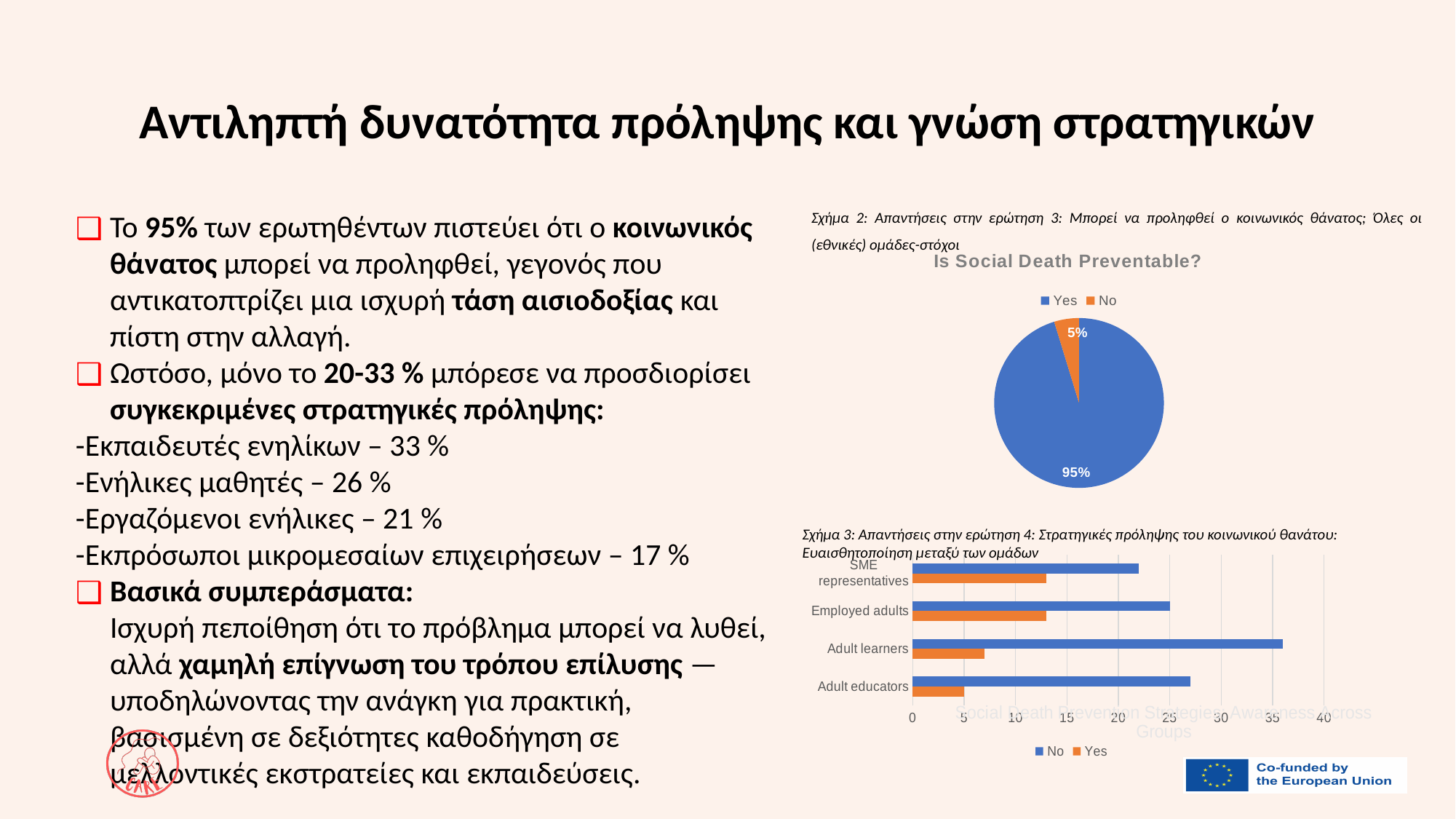
On the pie chart 'Is Social Death Preventable?', by how many percentage points does Yes exceed No? 90 percentage points On the bar chart 'Social Death Prevention Strategies: Awareness Across Groups', is the 'Yes' value for Adult educators greater or less than 10? less On the bar chart 'Social Death Prevention Strategies: Awareness Across Groups', which is larger: the 'No' value for Adult learners or the 'No' value for Adult educators? Adult learners On the bar chart 'Social Death Prevention Strategies: Awareness Across Groups', is the 'No' value for Adult learners greater or less than 30? greater What kind of chart is the upper chart on the right, 'Is Social Death Preventable?'? Pie chart On the bar chart 'Social Death Prevention Strategies: Awareness Across Groups', how many series does the legend list? 2 On the pie chart 'Is Social Death Preventable?', what percentage answered Yes? 95% On the bar chart 'Social Death Prevention Strategies: Awareness Across Groups', which group has the highest 'No' value? Adult learners On the pie chart 'Is Social Death Preventable?', which answer has the larger slice? Yes On the bar chart 'Social Death Prevention Strategies: Awareness Across Groups', how many groups are shown on the vertical axis? 4 On the pie chart 'Is Social Death Preventable?', what percentage answered No? 5% What kind of chart is the lower chart on the right, 'Social Death Prevention Strategies: Awareness Across Groups'? Bar chart